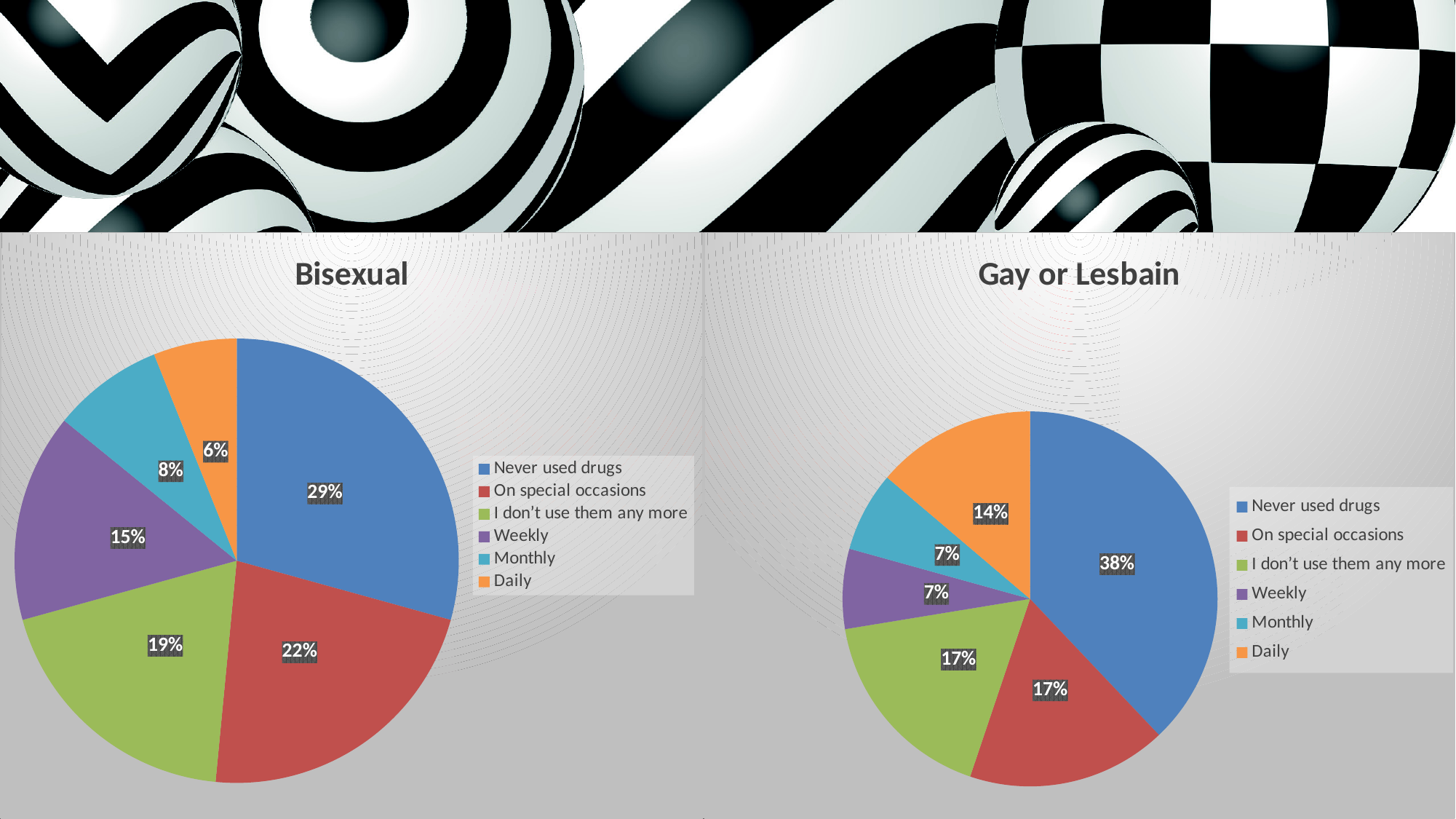
In the "Bisexual" pie chart, which colour represents "Monthly"? Teal (light blue) In the "Gay or Lesbain" pie chart, what share is labelled for "I don't use them any more"? 17% Which chart shows a larger share for "Never used drugs", "Bisexual" or "Gay or Lesbain"? Gay or Lesbain In the "Bisexual" pie chart, what is the difference between the "On special occasions" and "Monthly" shares? 14% How many categories does the "Bisexual" pie chart have? 6 In the "Gay or Lesbain" pie chart, which category has the largest slice? Never used drugs In the "Bisexual" pie chart, what share is labelled for "Never used drugs"? 29% In the "Bisexual" pie chart, what share is labelled for "Weekly"? 15% What type of chart is used for "Gay or Lesbain"? Pie chart In the "Gay or Lesbain" pie chart, what share is labelled for "Daily"? 14% In the "Bisexual" pie chart, which category has the smallest slice? Daily In the "Gay or Lesbain" pie chart, what share is labelled for "Never used drugs"? 38%